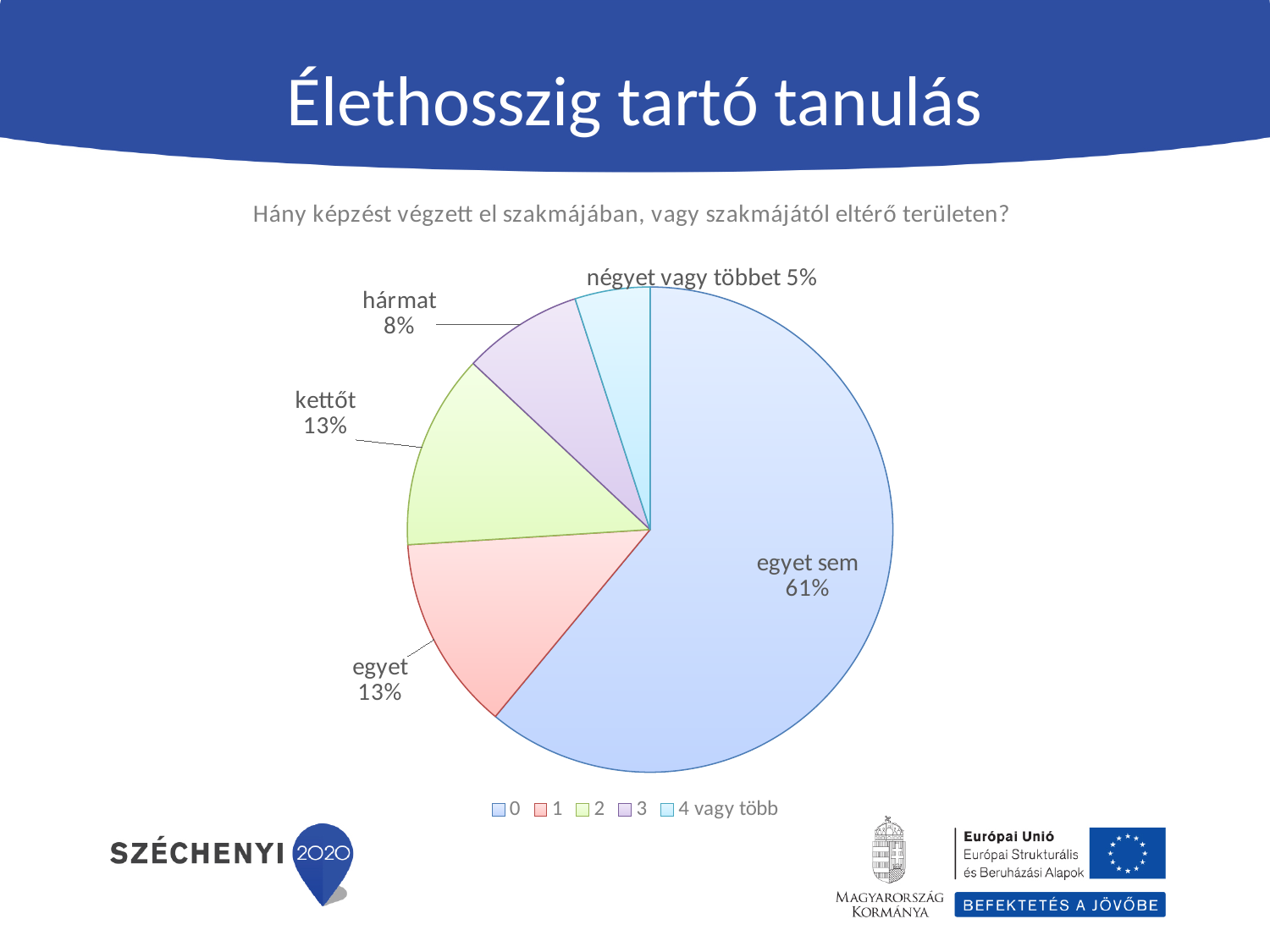
What share of the pie does "egyet sem" take? 61% Which is larger, the slice for "hármat" or the slice for "négyet vagy többet"? hármat Which slice of the pie is the largest? egyet sem What is the difference in percentage points between "egyet sem" and "egyet"? 48 What kind of chart is shown on the slide? pie chart How many slices does the pie chart have? 5 Which slice of the pie is the smallest? négyet vagy többet What is the chart's title (the question above the pie)? Hány képzést végzett el szakmájában, vagy szakmájától eltérő területen? What percentage is shown for "négyet vagy többet"? 5% What percentage is shown for "hármat"? 8% What percentage is shown for "kettőt"? 13% How many entries does the legend list? 5